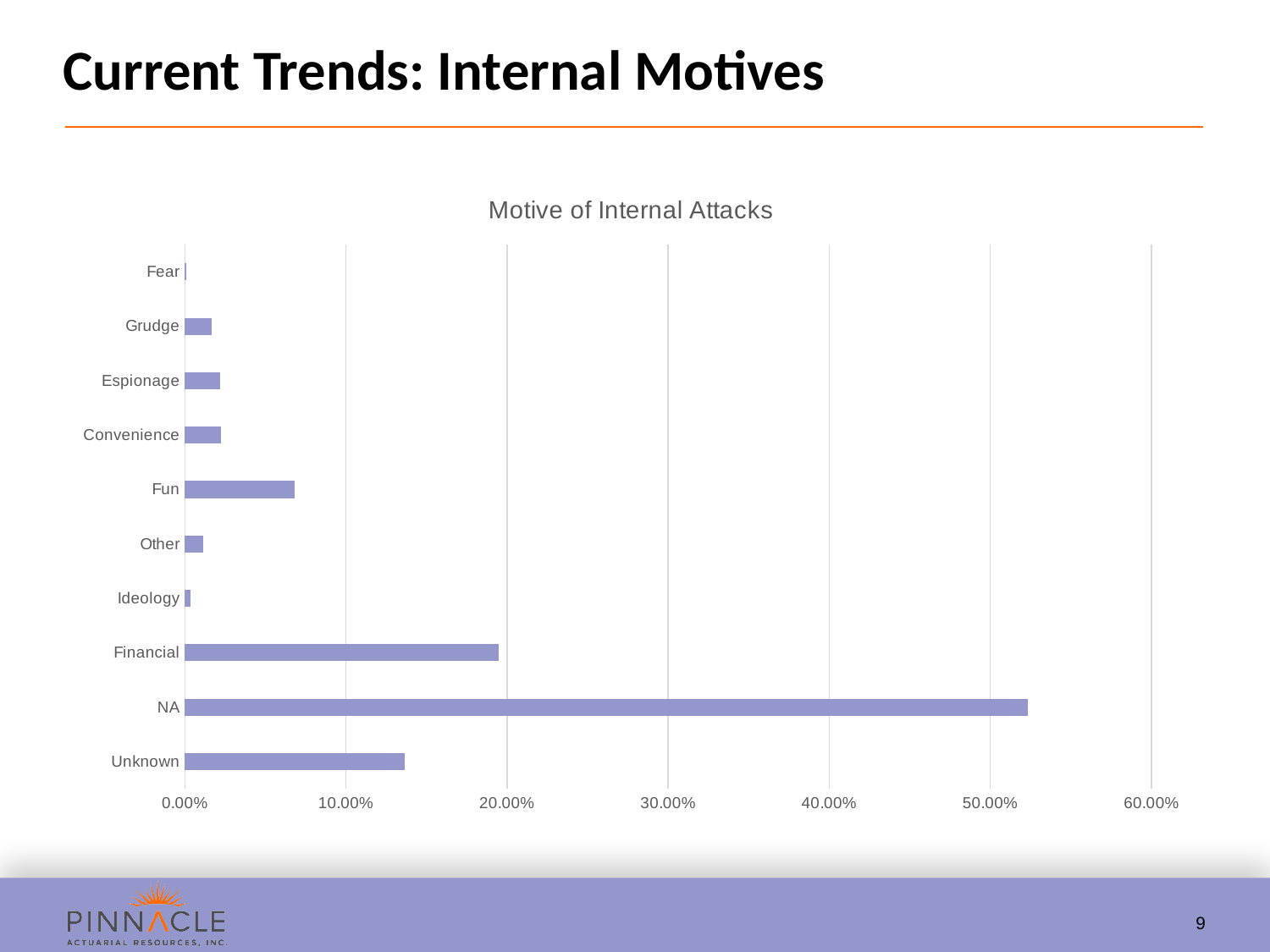
Is the value for Unknown greater or less than 10.00%? greater Is the value for NA greater or less than 50.00%? greater Is the value for Financial greater or less than 10.00%? greater Which is larger, the value for Fun or the value for Grudge? Fun How many motive categories are plotted in the chart? 10 Which motive has the highest value? NA Which motive has the lowest value? Fear What kind of chart is shown on the slide? bar chart What is the title of the chart? Motive of Internal Attacks What is the highest value shown on the horizontal axis? 60.00% Which is larger, the value for Financial or the value for Unknown? Financial